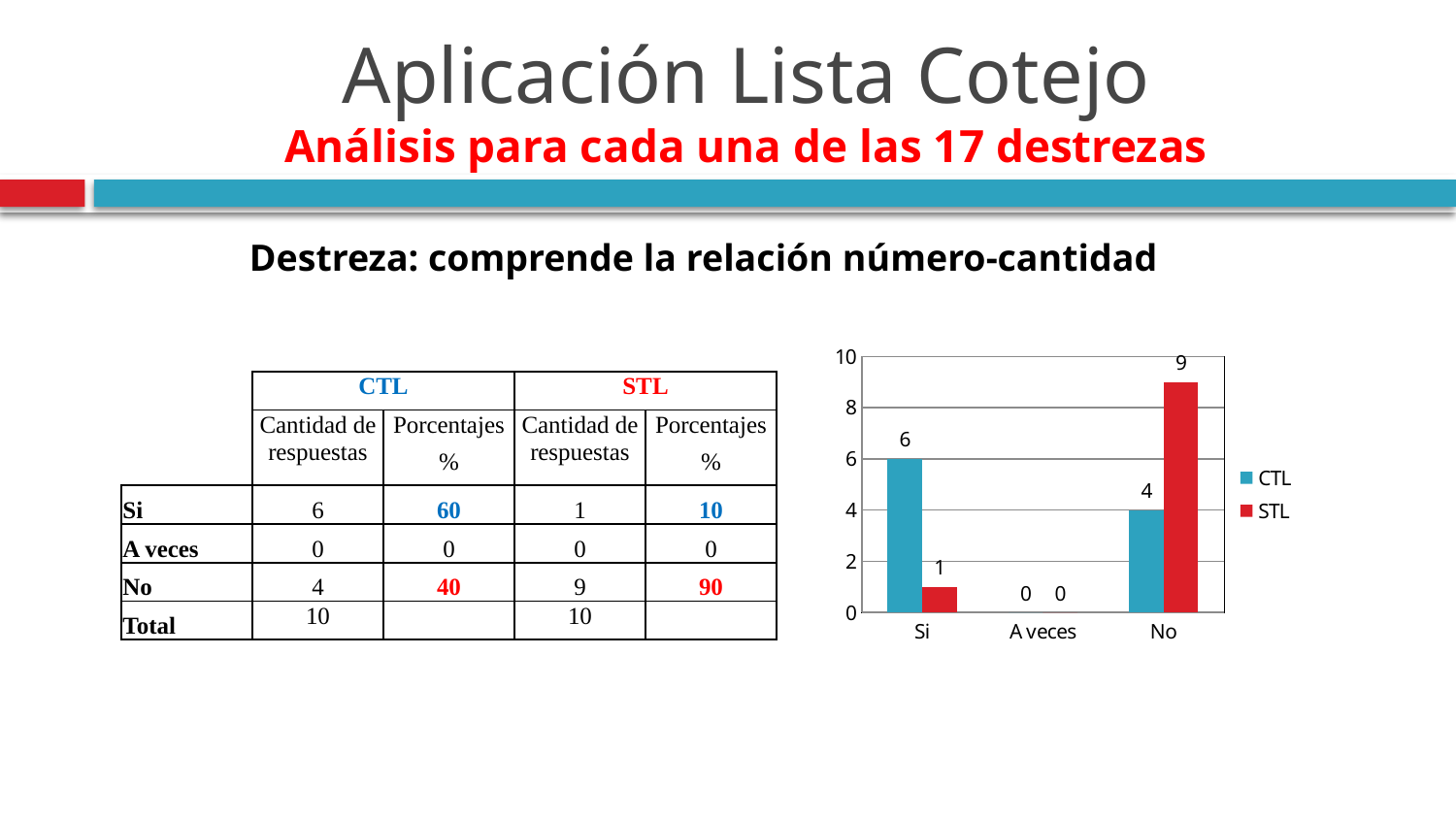
What is the value for STL in the Si category? 1 Which category has the highest STL value? No What is the value for CTL in the Si category? 6 What is the value for CTL in the No category? 4 Which colour represents the STL series in the chart? red How many categories are shown on the x axis of the chart? 3 How many series does the chart legend list? 2 What is the value for STL in the No category? 9 Which category has the highest CTL value? Si What kind of chart is shown on the slide? bar chart Which is larger in the Si category, CTL or STL? CTL What is the difference between the STL value and the CTL value in the No category? 5